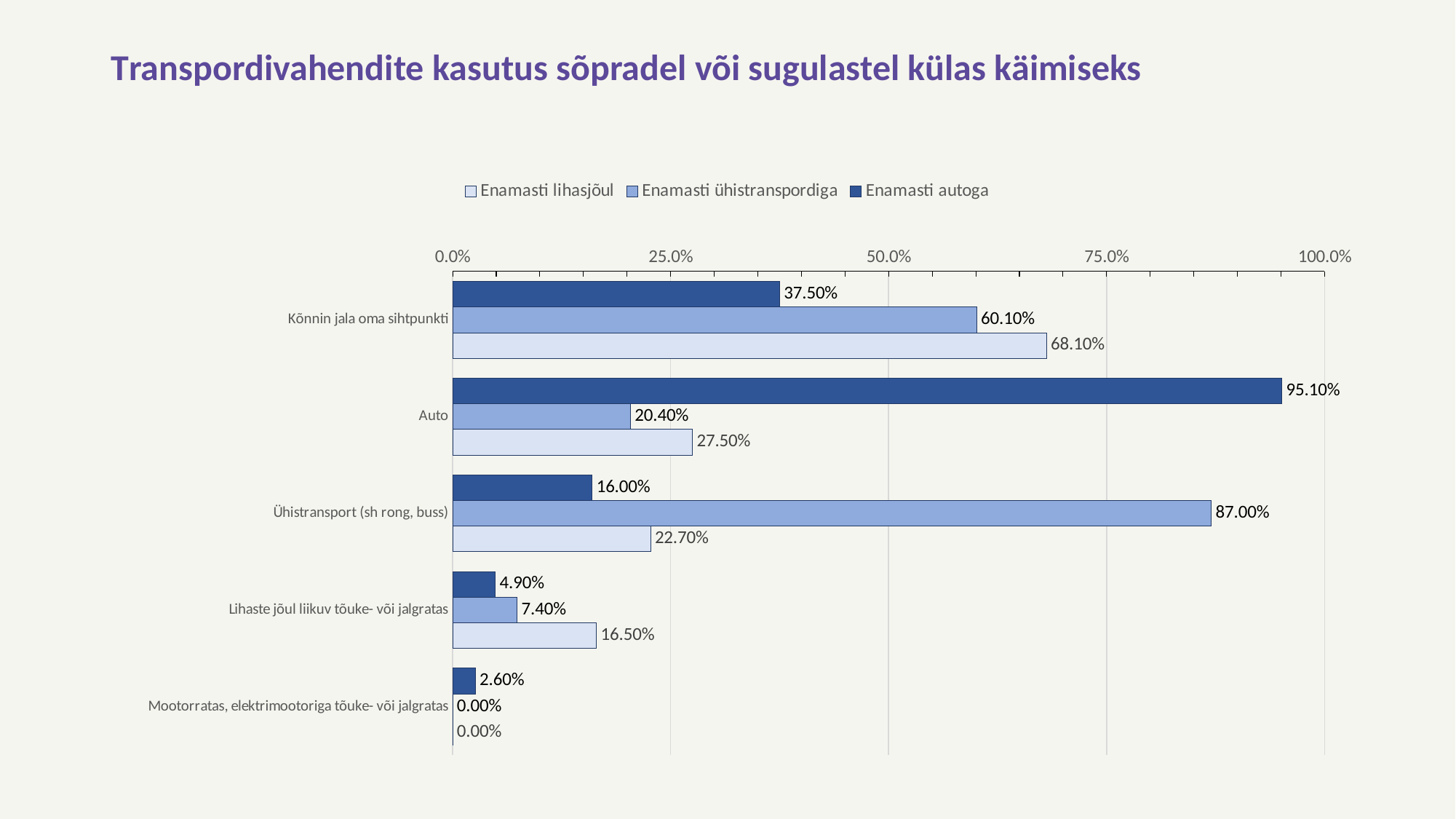
In the 'Lihaste jõul liikuv tõuke- või jalgratas' category, which series has the larger value: 'Enamasti lihasjõul' or 'Enamasti ühistranspordiga'? Enamasti lihasjõul What is the value for 'Enamasti autoga' in the 'Auto' category? 95.10% Is the value for 'Enamasti ühistranspordiga' in the 'Kõnnin jala oma sihtpunkti' category greater or less than 50.0%? greater What is the value for 'Enamasti ühistranspordiga' in the 'Ühistransport (sh rong, buss)' category? 87.00% How many series does the legend list? 3 What is the difference between the 'Enamasti lihasjõul' and 'Enamasti autoga' values in the 'Kõnnin jala oma sihtpunkti' category? 30.60% Which category has the lowest value for the 'Enamasti autoga' series? Mootorratas, elektrimootoriga tõuke- või jalgratas What kind of chart is shown on the slide? Bar chart What is the value for 'Enamasti lihasjõul' in the 'Kõnnin jala oma sihtpunkti' category? 68.10% Which category has the highest value for the 'Enamasti lihasjõul' series? Kõnnin jala oma sihtpunkti How many categories are shown on the chart? 5 What is the value for 'Enamasti autoga' in the 'Mootorratas, elektrimootoriga tõuke- või jalgratas' category? 2.60%